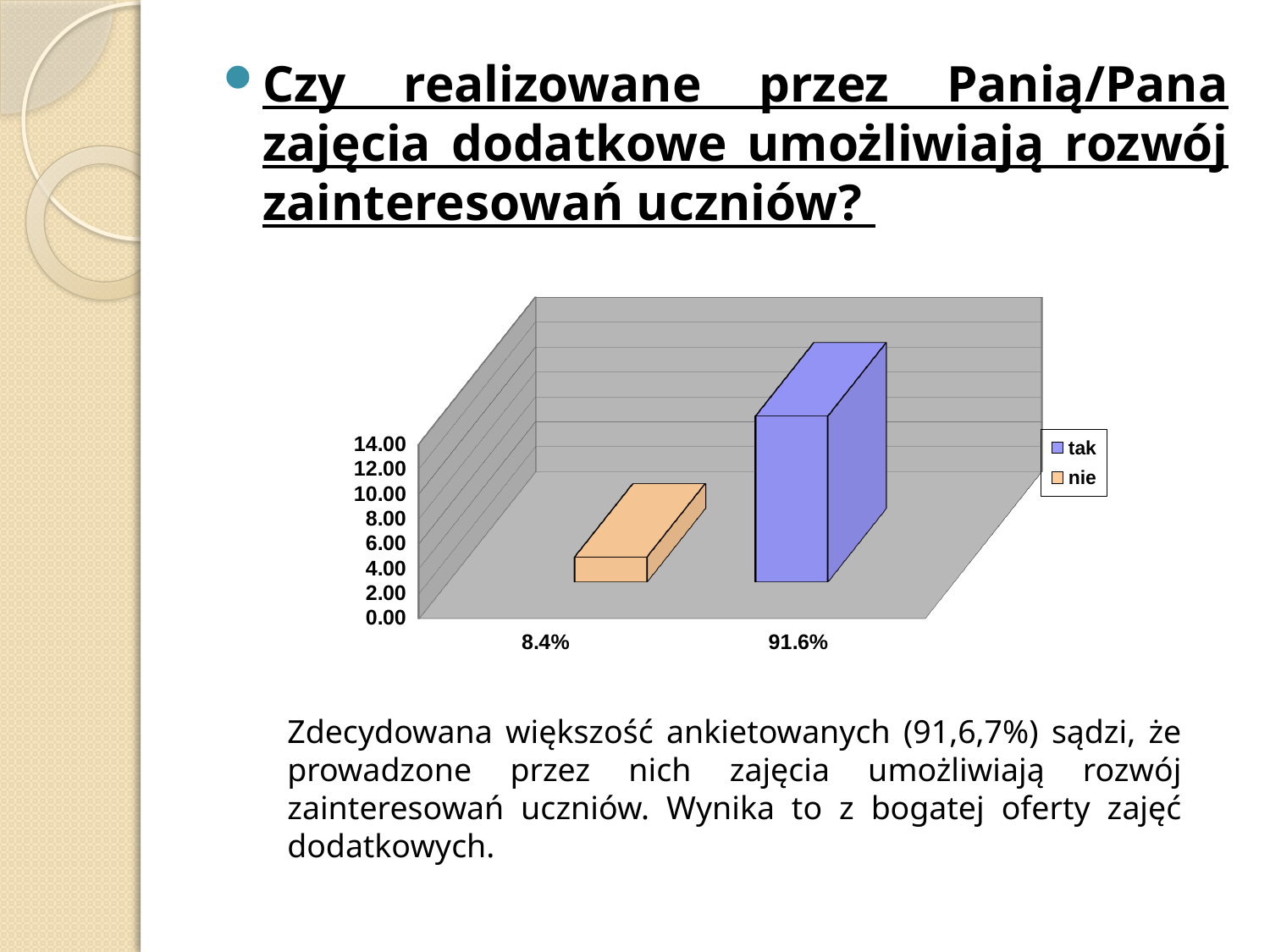
Is the bar for tak taller or shorter than the bar for nie? taller Is the value for nie greater or less than 6.00? less What percentage label appears on the x axis under the nie bar? 8.4% Which series has the tallest bar, tak or nie? tak Is the value for tak greater or less than 6.00? greater Which series has the shortest bar, tak or nie? nie What percentage label appears on the x axis under the tak bar? 91.6% What is the highest value shown on the vertical axis? 14.00 What kind of chart is shown on the slide? bar chart How many series does the legend list? 2 How many bars are plotted in the chart? 2 What colour is the bar for the series tak? blue